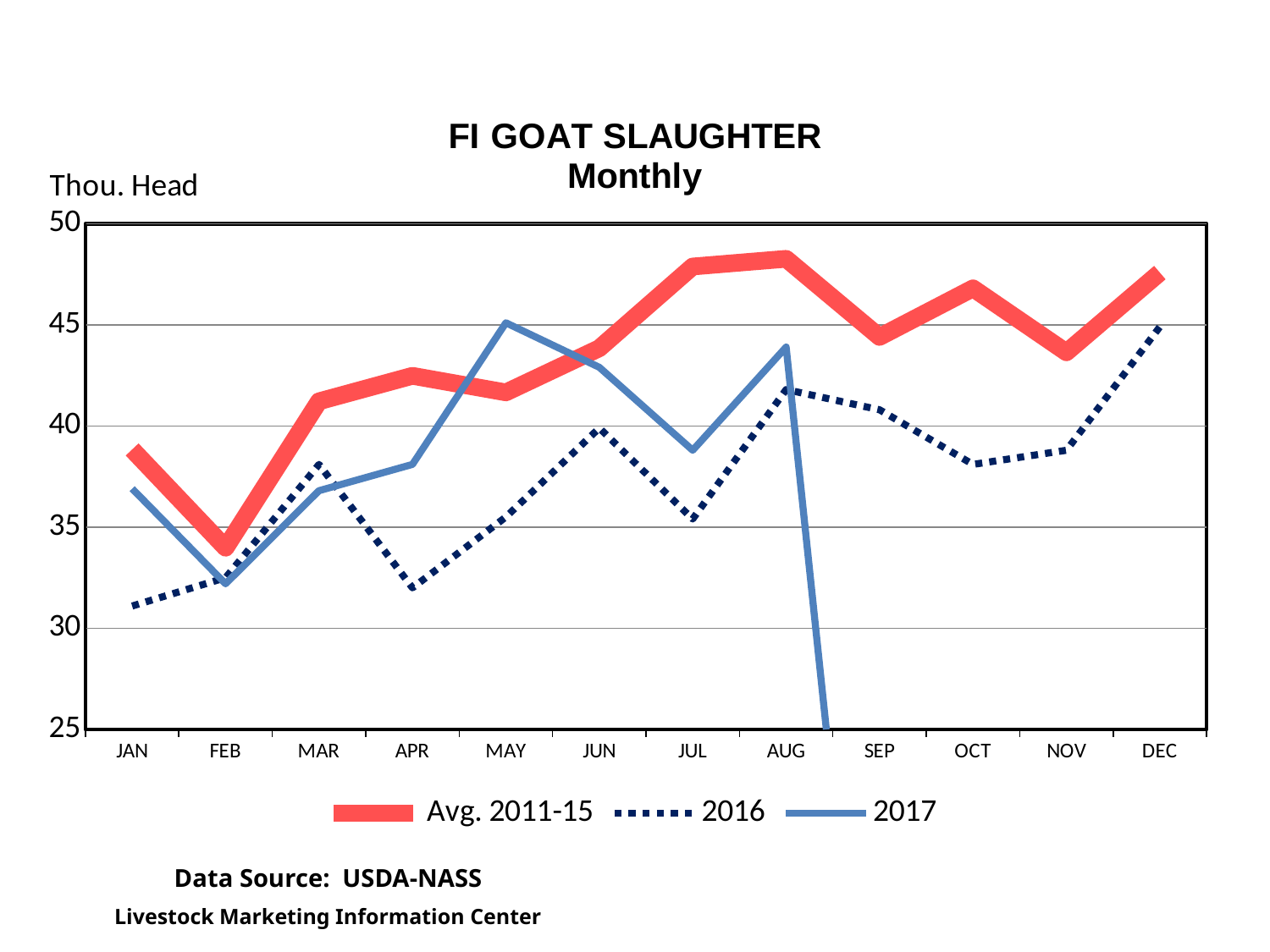
In MAY, which series is higher: 2017 or Avg. 2011-15? 2017 Is the 2016 value for APR greater or less than 35? less What unit is shown for the y axis? Thou. Head What kind of chart is shown on the slide? line chart In which month is the 2016 series at its highest? DEC Is the Avg. 2011-15 value for AUG greater or less than 45? greater Is the 2016 value for JAN greater or less than 35? less How many months are shown along the x axis? 12 In JAN, which series is higher: Avg. 2011-15 or 2016? Avg. 2011-15 In which month is the Avg. 2011-15 series at its lowest? FEB How many series does the legend list? 3